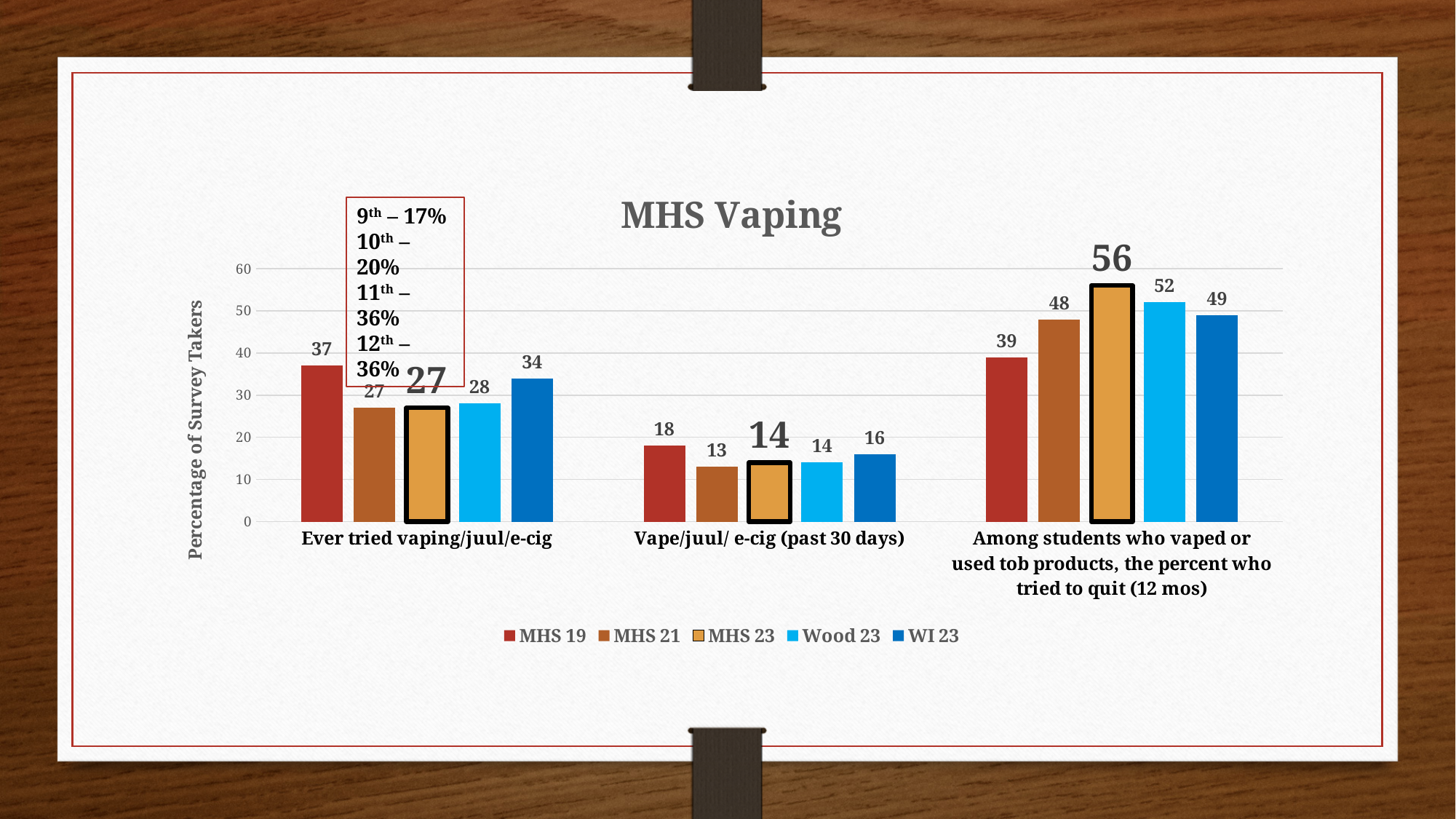
Which series has the lowest value in the "Vape/juul/ e-cig (past 30 days)" category? MHS 21 Which is larger for "Ever tried vaping/juul/e-cig": the WI 23 value or the Wood 23 value? WI 23 What is the MHS 19 value for "Ever tried vaping/juul/e-cig"? 37 What kind of chart is shown on the slide? bar chart What is the difference between the MHS 19 and MHS 21 values for "Ever tried vaping/juul/e-cig"? 10 What is the MHS 23 value for "Vape/juul/ e-cig (past 30 days)"? 14 How many series does the legend list? 5 Is the MHS 23 value for the tried-to-quit category greater or less than 50? greater What is the title of the chart? MHS Vaping Which series has the highest value in the "Among students who vaped or used tob products, the percent who tried to quit (12 mos)" category? MHS 23 What is the Wood 23 value for the category about students who tried to quit (12 mos)? 52 How many categories are shown on the x axis? 3